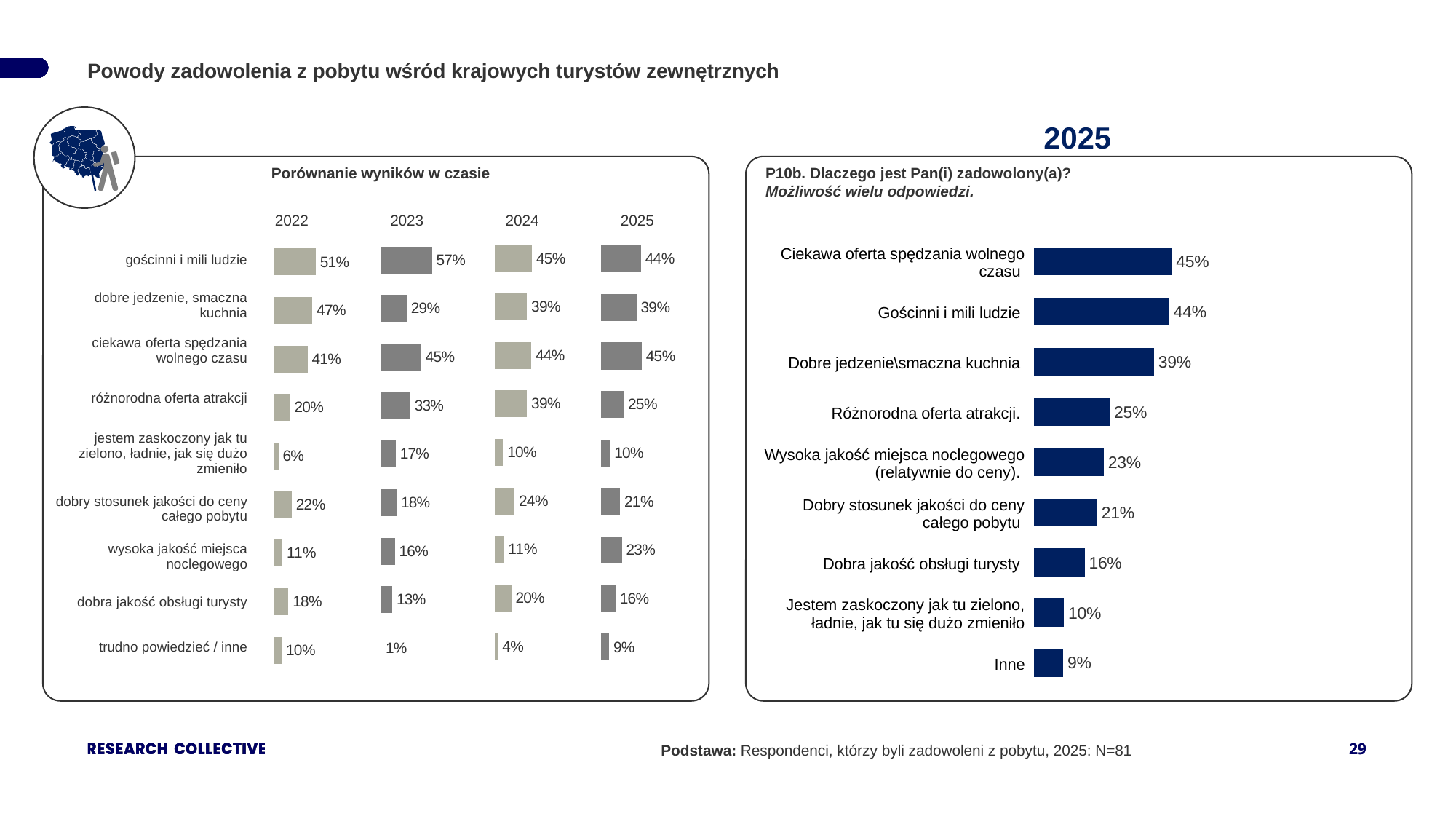
In the "Porównanie wyników w czasie" chart, how many years are compared? 4 In the "Porównanie wyników w czasie" chart, what is the difference between the 2024 and 2025 values for "wysoka jakość miejsca noclegowego"? 12% In the 2025 chart on the right, what is the difference between "Dobre jedzenie\smaczna kuchnia" and "Różnorodna oferta atrakcji"? 14% In the 2025 chart on the right, how many categories are shown? 9 In the "Porównanie wyników w czasie" chart, what is the value for "trudno powiedzieć / inne" in 2023? 1% In the "Porównanie wyników w czasie" chart, does the value for "różnorodna oferta atrakcji" rise or fall from 2024 to 2025? Fall In the "Porównanie wyników w czasie" chart, what is the value for "gościnni i mili ludzie" in 2023? 57% What kind of chart is the 2025 chart on the right? Bar chart In the 2025 chart on the right, what is the value for "Ciekawa oferta spędzania wolnego czasu"? 45% In the 2025 chart on the right, which category has the highest value? Ciekawa oferta spędzania wolnego czasu In the 2025 chart on the right, which category has the lowest value? Inne In the "Porównanie wyników w czasie" chart, which is larger for "dobre jedzenie, smaczna kuchnia": 2022 or 2023? 2022